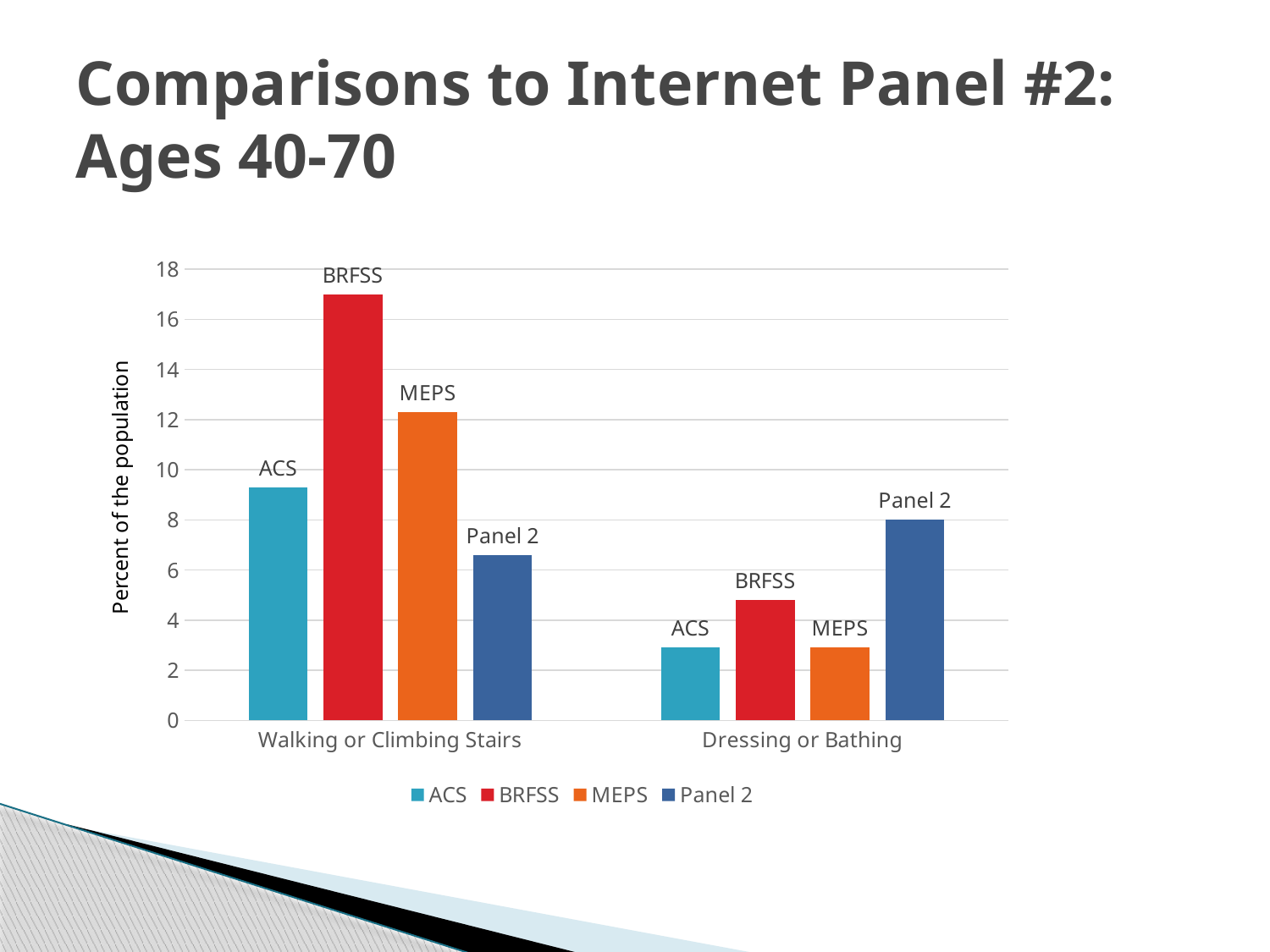
How many series does the legend list? 4 How many categories are shown on the x axis? 2 Is the ACS value for Walking or Climbing Stairs greater or less than 10? less Which series has the highest value for Walking or Climbing Stairs? BRFSS Which is larger: the BRFSS value for Walking or Climbing Stairs or the BRFSS value for Dressing or Bathing? Walking or Climbing Stairs Is the BRFSS value for Dressing or Bathing greater or less than 6? less What is the title of the vertical axis? Percent of the population Which series has the highest value for Dressing or Bathing? Panel 2 Is the Panel 2 value for Dressing or Bathing greater or less than 6? greater Which series has the lowest value for Walking or Climbing Stairs? Panel 2 What kind of chart is shown on the slide? bar chart